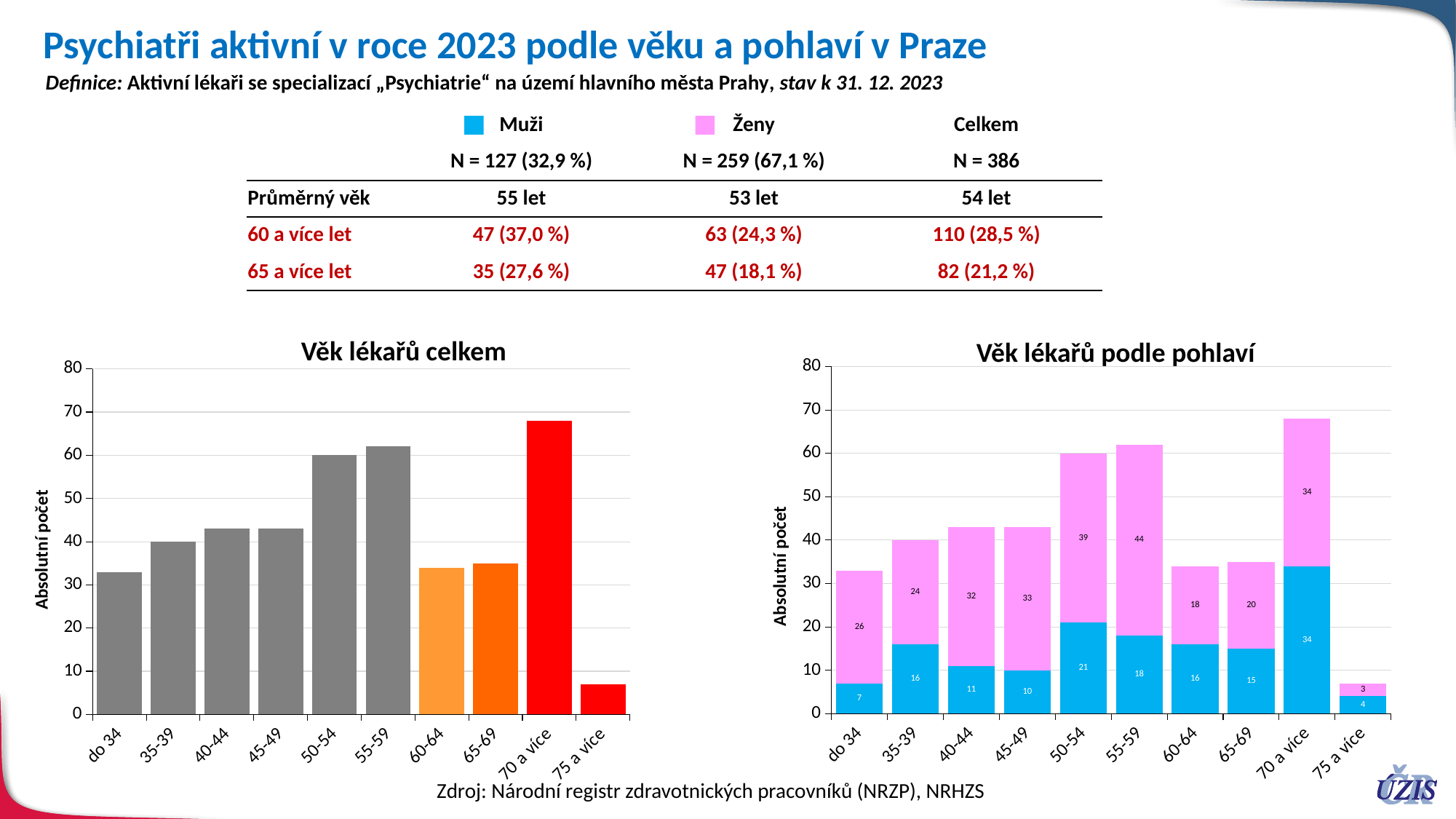
In the chart 'Věk lékařů celkem', how many age groups are shown on the x axis? 10 What type of chart is 'Věk lékařů podle pohlaví'? stacked bar chart In the chart 'Věk lékařů podle pohlaví', what is the value for Ženy in the 55-59 age group? 44 In the chart 'Věk lékařů celkem', which age group has the highest bar? 70 a více In the chart 'Věk lékařů podle pohlaví', what is the total of the stacked bar for the 70 a více age group? 68 In the chart 'Věk lékařů podle pohlaví', which age group has the lowest value for Muži? 75 a více In the chart 'Věk lékařů podle pohlaví', which is larger in the 60-64 age group, Muži or Ženy? Ženy In the chart 'Věk lékařů celkem', is the value for 'do 34' greater or less than 30? greater In the chart 'Věk lékařů podle pohlaví', what is the difference between Ženy and Muži in the 40-44 age group? 21 In the chart 'Věk lékařů podle pohlaví', what is the value for Muži in the 50-54 age group? 21 In the chart 'Věk lékařů celkem', which age group has the lowest bar? 75 a více In the chart 'Věk lékařů celkem', what is the value for the 35-39 age group? 40